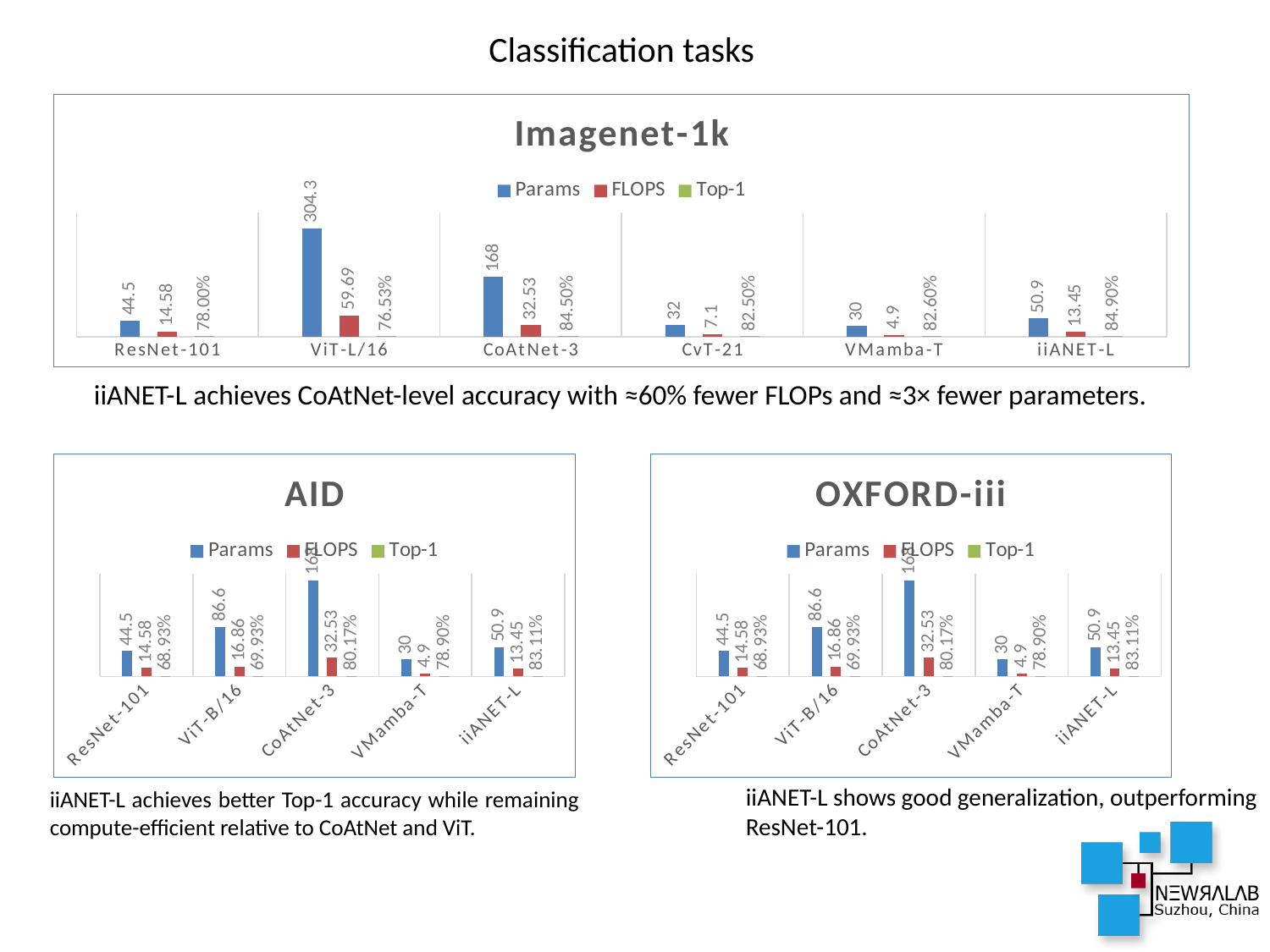
In the Imagenet-1k chart, which model has the lowest FLOPS value? VMamba-T In the Imagenet-1k chart, what is the difference in FLOPS between CoAtNet-3 and iiANET-L? 19.08 In the OXFORD-iii chart, what is the FLOPS value for VMamba-T? 4.9 How many series does the legend of the Imagenet-1k chart list? 3 In the Imagenet-1k chart, what is the Params value for ViT-L/16? 304.3 In the Imagenet-1k chart, which model has the highest Params value? ViT-L/16 In the Imagenet-1k chart, which has the larger Params value, ResNet-101 or iiANET-L? iiANET-L In the AID chart, what is the Top-1 value for iiANET-L? 83.11% What kind of chart is the AID chart? Bar chart How many models are shown on the x axis of the Imagenet-1k chart? 6 In the AID chart, what is the Params value for ViT-B/16? 86.6 In the Imagenet-1k chart, what is the Top-1 value for iiANET-L? 84.90%